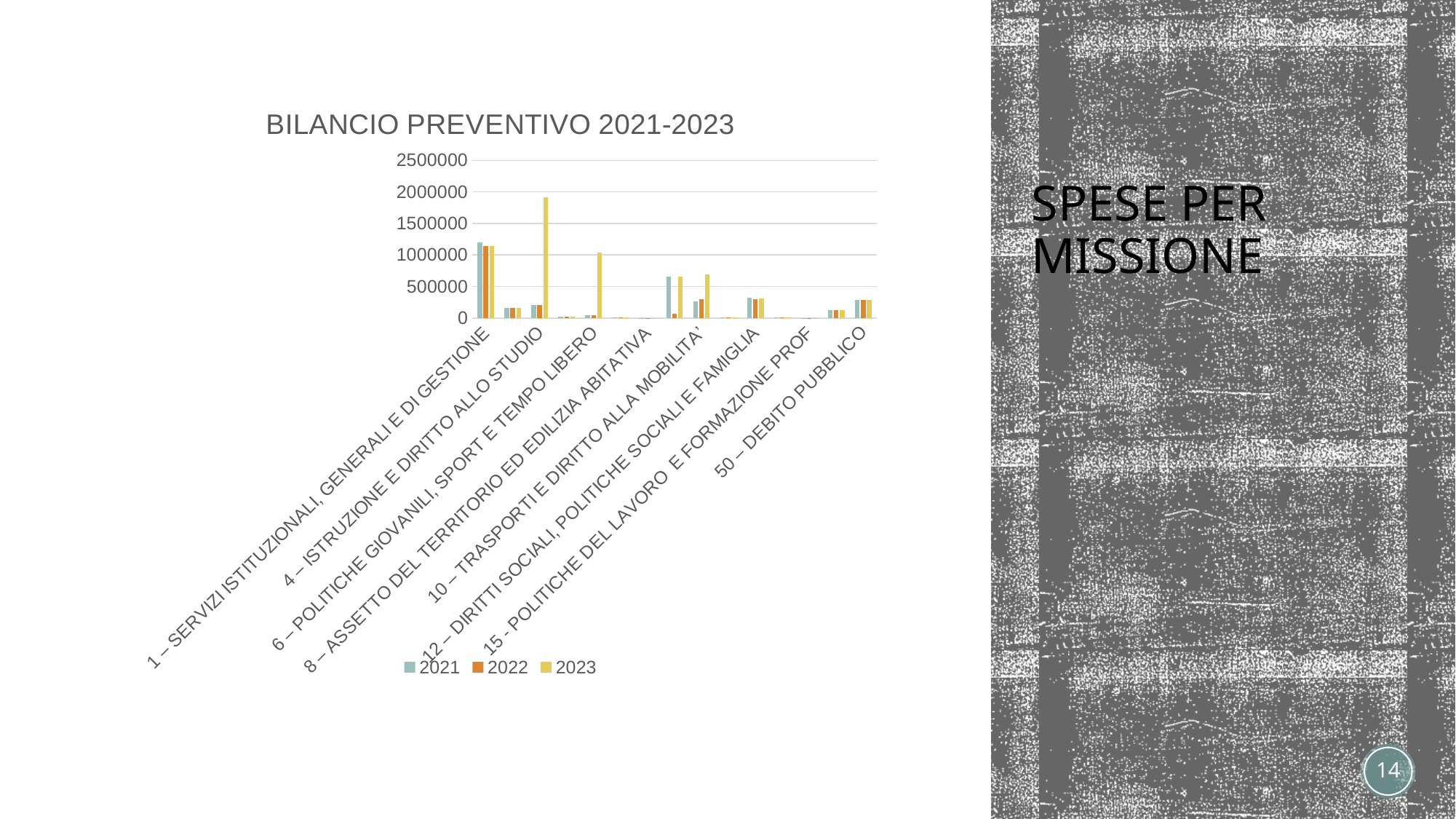
Is the 2022 value for "1 – SERVIZI ISTITUZIONALI, GENERALI E DI GESTIONE" greater or less than 500000? greater Which category has the highest 2023 value? 4 – ISTRUZIONE E DIRITTO ALLO STUDIO What is the highest value shown on the vertical axis of the chart? 2500000 How many series does the legend of the chart list? 3 What are the series names listed in the chart legend? 2021, 2022, 2023 Which series has the tallest bar in the chart? 2023 Is the 2023 value for "6 – POLITICHE GIOVANILI, SPORT E TEMPO LIBERO" greater or less than 500000? greater What is the title of the chart? BILANCIO PREVENTIVO 2021-2023 Is the 2021 value for "1 – SERVIZI ISTITUZIONALI, GENERALI E DI GESTIONE" greater or less than 1000000? greater What kind of chart is shown on the slide? bar chart